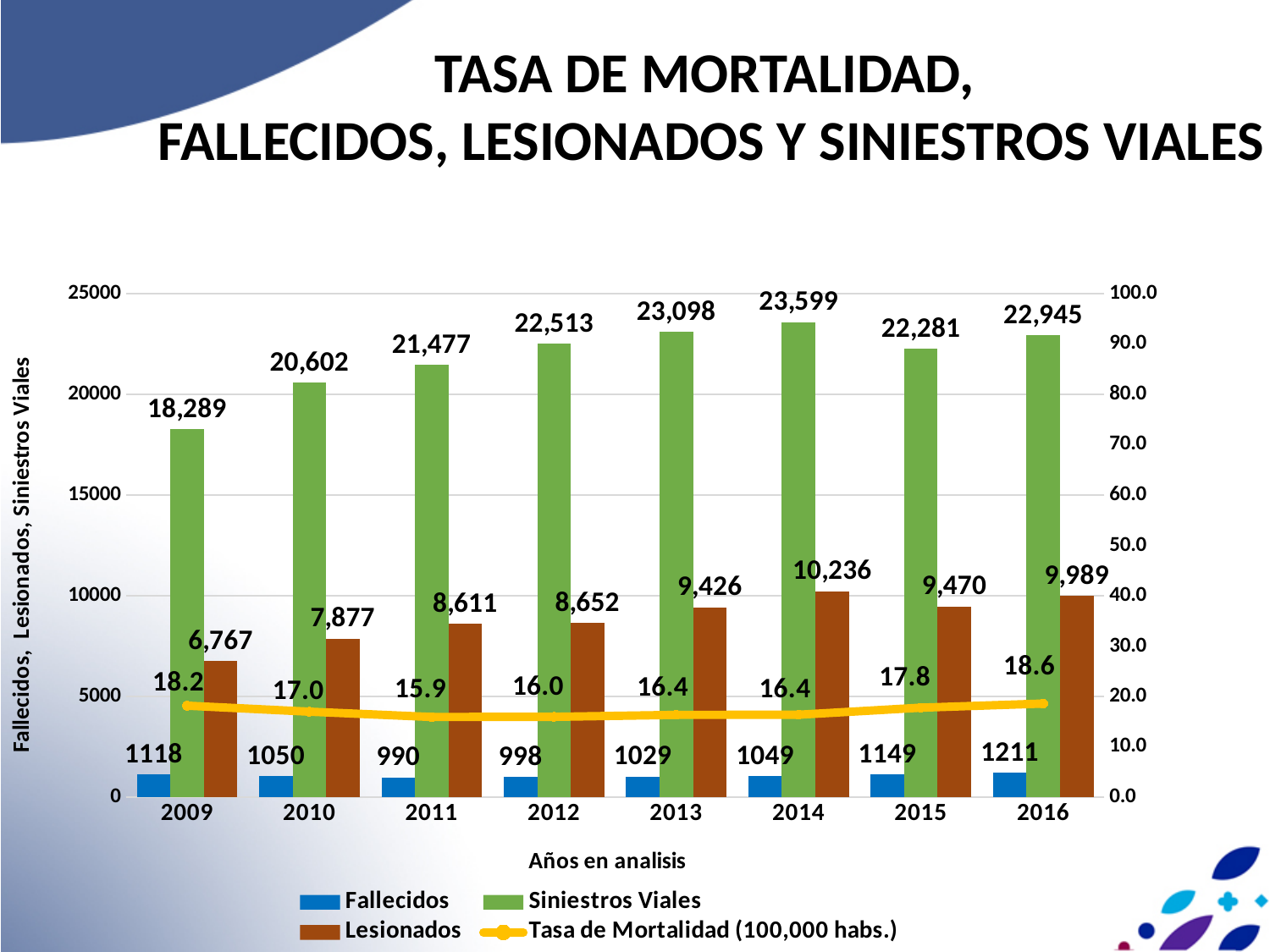
What is the Tasa de Mortalidad (100,000 habs.) in 2009? 18.2 What is the value of Fallecidos in 2016? 1211 How many years are shown on the x axis? 8 What is the x-axis title of the chart? Años en analisis How many series does the legend list? 4 What is the difference between Lesionados in 2014 and Lesionados in 2009? 3,469 In which year is Siniestros Viales highest? 2014 In which year is Fallecidos lowest? 2011 Which is larger, Siniestros Viales in 2015 or Siniestros Viales in 2016? 2016 What is the value of Siniestros Viales in 2014? 23,599 What is the value of Lesionados in 2011? 8,611 What kind of chart is used for the Siniestros Viales series? bar chart